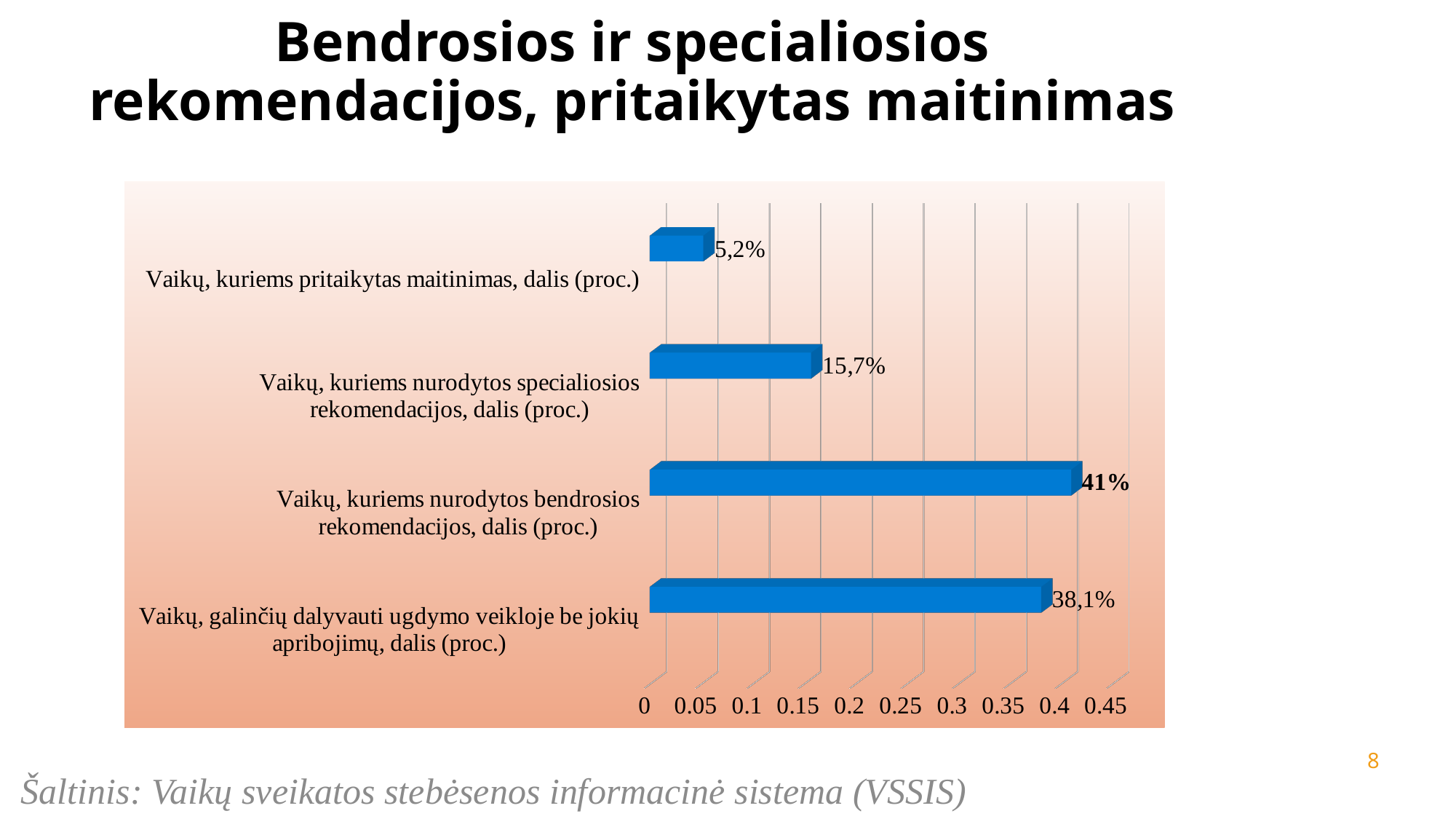
How many categories are shown in the chart? 4 Is the value for 'Vaikų, galinčių dalyvauti ugdymo veikloje be jokių apribojimų' greater or less than 0.4? less Which category has the lowest value? Vaikų, kuriems pritaikytas maitinimas, dalis (proc.) What is the value for 'Vaikų, kuriems pritaikytas maitinimas, dalis (proc.)'? 5,2% What is the value for 'Vaikų, galinčių dalyvauti ugdymo veikloje be jokių apribojimų, dalis (proc.)'? 38,1% What is the value for 'Vaikų, kuriems nurodytos specialiosios rekomendacijos, dalis (proc.)'? 15,7% Which is larger: the value for 'Vaikų, kuriems nurodytos specialiosios rekomendacijos' or the value for 'Vaikų, kuriems pritaikytas maitinimas'? Vaikų, kuriems nurodytos specialiosios rekomendacijos Which category has the highest value? Vaikų, kuriems nurodytos bendrosios rekomendacijos, dalis (proc.) Is the value for 'Vaikų, kuriems nurodytos bendrosios rekomendacijos' greater or less than 0.4? greater What is the value for 'Vaikų, kuriems nurodytos bendrosios rekomendacijos, dalis (proc.)'? 41% What kind of chart is shown on the slide? Bar chart What is the difference between the value for 'Vaikų, kuriems nurodytos bendrosios rekomendacijos' and the value for 'Vaikų, galinčių dalyvauti ugdymo veikloje be jokių apribojimų'? 2,9 percentage points